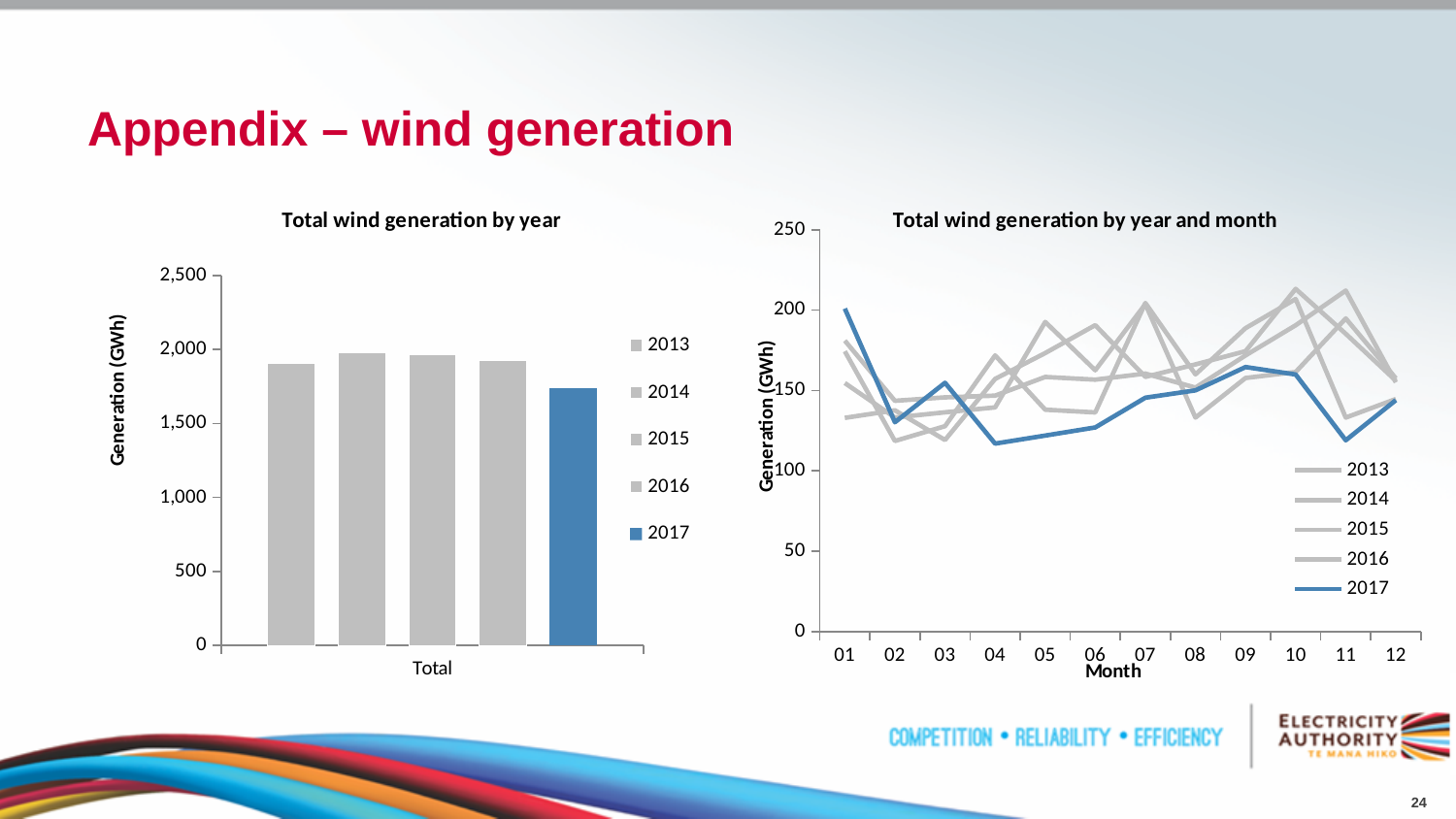
In the 'Total wind generation by year and month' chart, is the 2017 value for month 04 greater or less than 150? less In the 'Total wind generation by year' chart, is the value for 2017 greater or less than 1,500? greater In the 'Total wind generation by year' chart, how many series does the legend list? 5 What kind of chart is the 'Total wind generation by year' chart on the left? bar chart In the 'Total wind generation by year and month' chart, how many series does the legend list? 5 What kind of chart is the 'Total wind generation by year and month' chart on the right? line chart In the 'Total wind generation by year' chart, how many bars are plotted? 5 In the 'Total wind generation by year' chart, is the value for 2013 greater or less than 2,000? less In the 'Total wind generation by year and month' chart, does the 2017 line rise or fall from month 01 to month 02? fall In the 'Total wind generation by year and month' chart, how many months are shown on the x axis? 12 In the 'Total wind generation by year and month' chart, which year is drawn with the blue line? 2017 In the 'Total wind generation by year' chart, which year has the lowest total generation? 2017